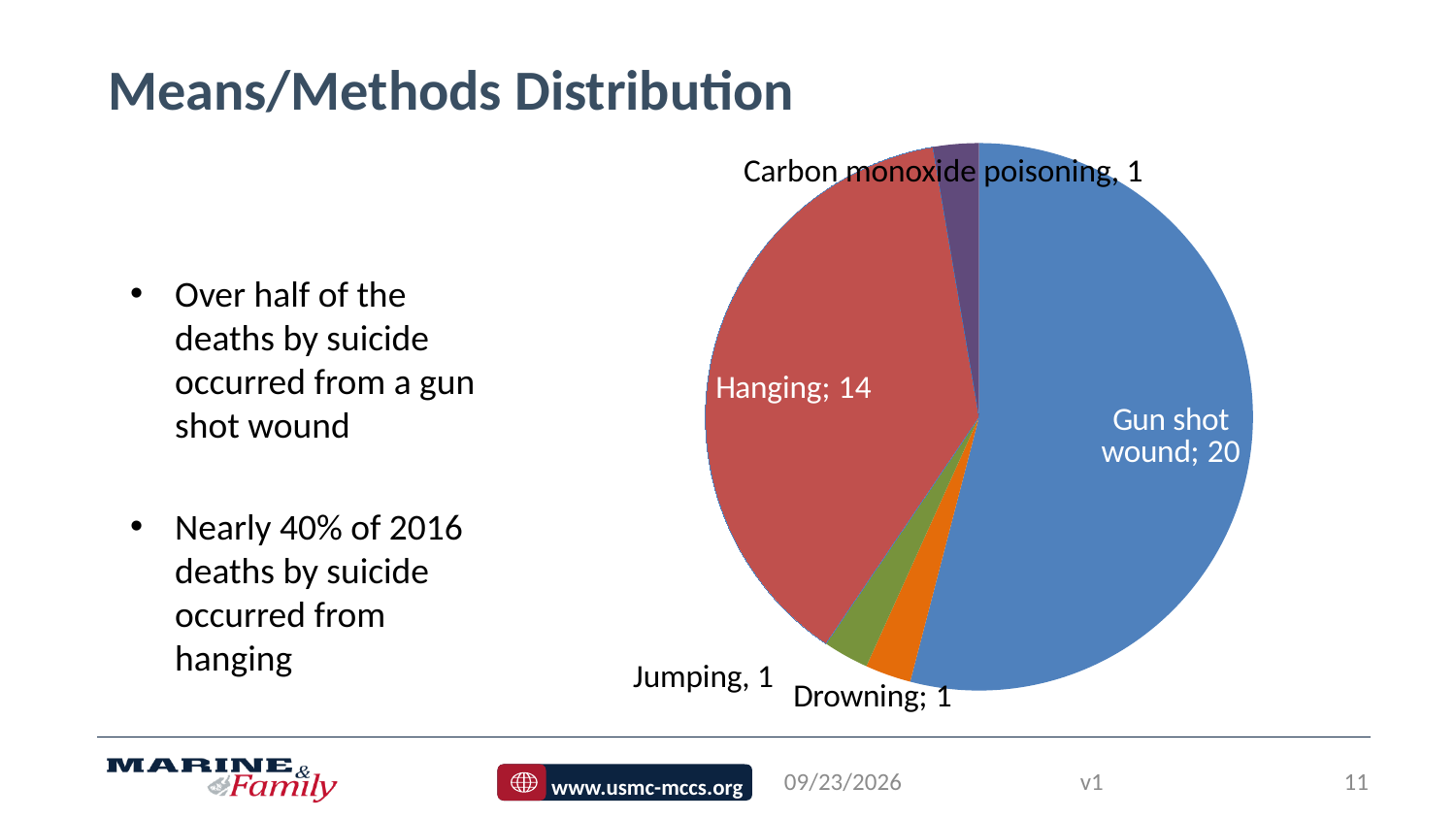
What kind of chart is shown on the slide? pie chart What is the total of all slices in the pie chart? 37 Which is larger, Hanging or Jumping? Hanging How many slices does the pie chart have? 5 What is the value for Gun shot wound? 20 What is the title of the slide containing the chart? Means/Methods Distribution What is the difference between the Gun shot wound and Hanging values? 6 What is the value for Hanging? 14 What is the value for Drowning? 1 Which category has the largest slice? Gun shot wound What is the value for Carbon monoxide poisoning? 1